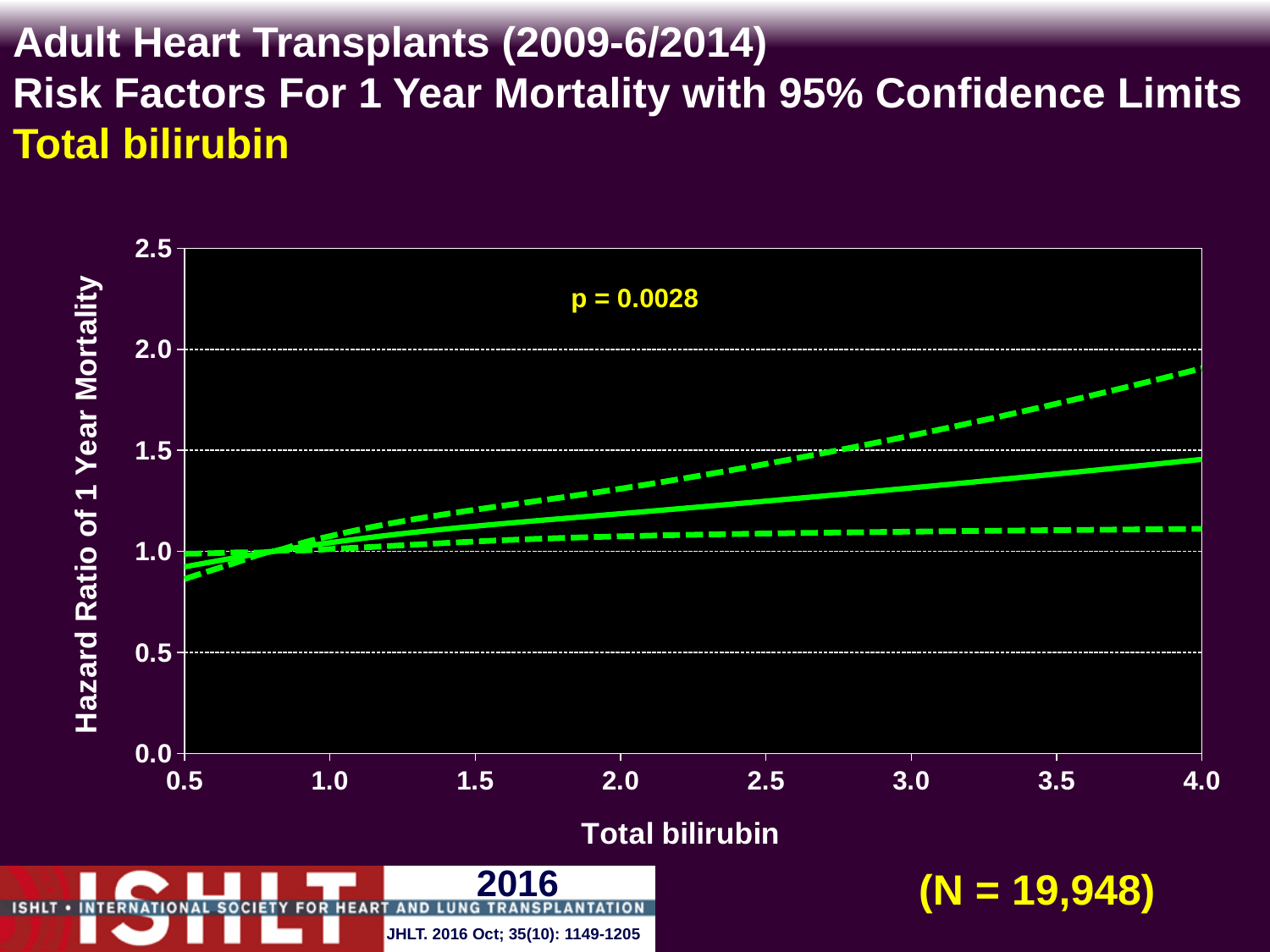
Is the hazard ratio (solid line) at a total bilirubin of 4.0 greater or less than 1.0? greater How many lines are plotted on the chart? 3 Is the lower 95% confidence limit (lower dashed line) at a total bilirubin of 4.0 greater or less than 1.5? less Does the hazard ratio of 1 year mortality rise or fall as total bilirubin increases from 0.5 to 4.0? rise What kind of chart is shown on the slide? line chart Is the upper 95% confidence limit (upper dashed line) at a total bilirubin of 4.0 greater or less than 1.5? greater What p-value is printed on the chart? p = 0.0028 What is the label of the y axis? Hazard Ratio of 1 Year Mortality